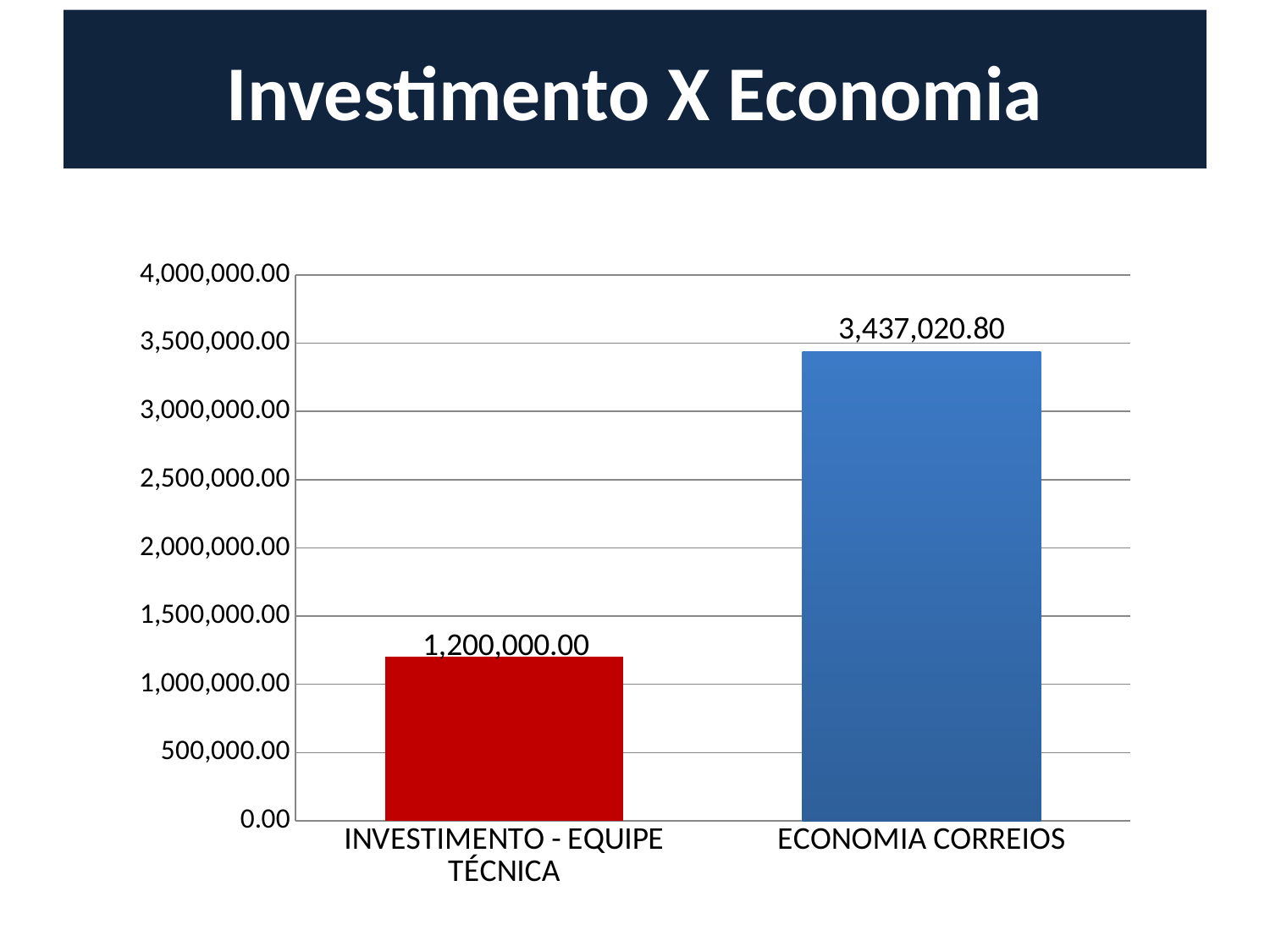
Which category has the highest value? ECONOMIA CORREIOS Is the value for ECONOMIA CORREIOS greater or less than 3,000,000.00? greater Which category has the lowest value? INVESTIMENTO - EQUIPE TÉCNICA What is the value for ECONOMIA CORREIOS? 3,437,020.80 Which is larger, the value for INVESTIMENTO - EQUIPE TÉCNICA or the value for ECONOMIA CORREIOS? ECONOMIA CORREIOS What is the title of the slide? Investimento X Economia What is the value for INVESTIMENTO - EQUIPE TÉCNICA? 1,200,000.00 Is the value for INVESTIMENTO - EQUIPE TÉCNICA greater or less than 1,500,000.00? less What is the difference between the value for ECONOMIA CORREIOS and the value for INVESTIMENTO - EQUIPE TÉCNICA? 2,237,020.80 What kind of chart is shown on the slide? bar chart How many categories are shown in the chart? 2 What colour is the bar for ECONOMIA CORREIOS? blue